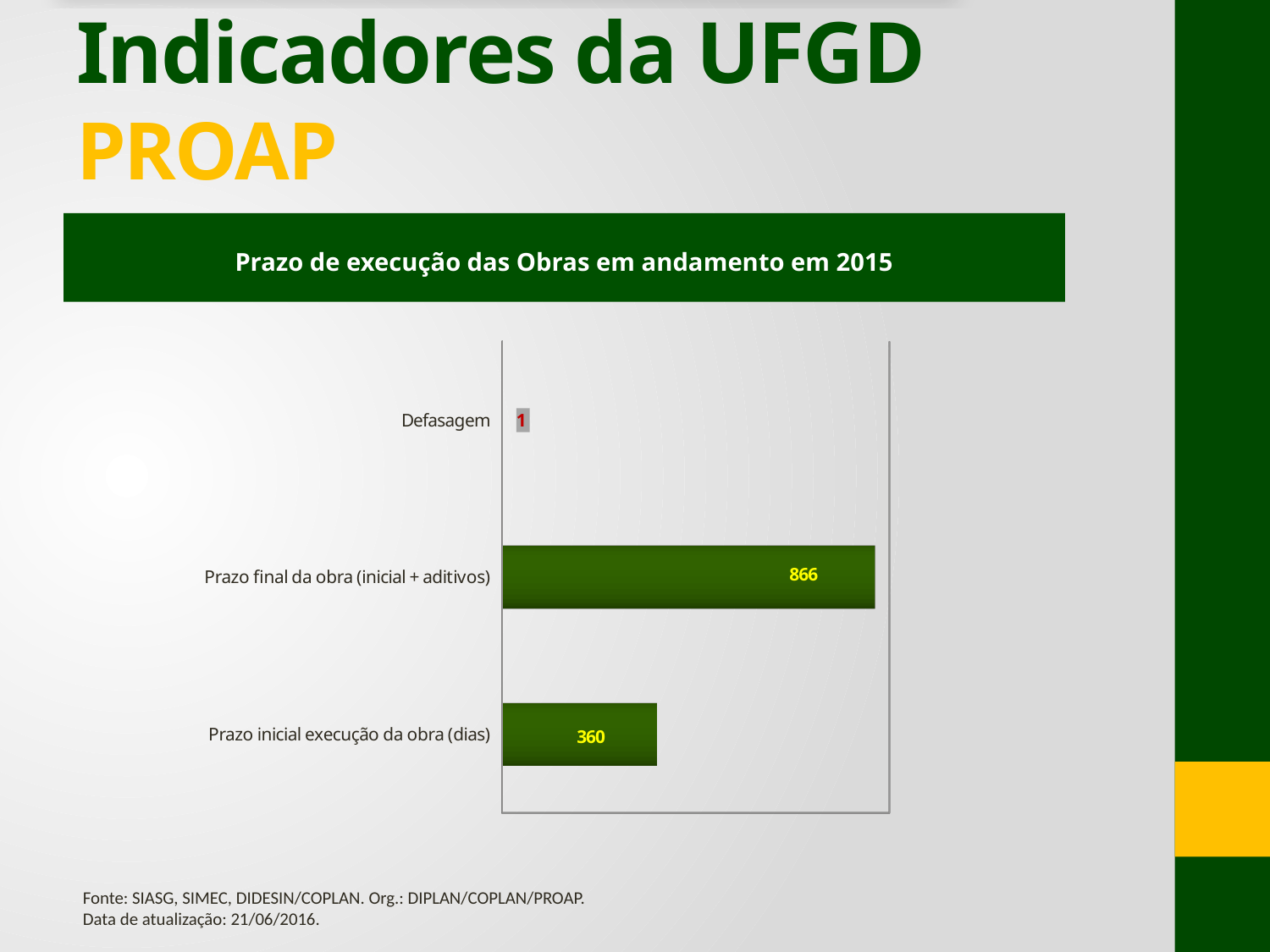
Which category has the highest value? Prazo final da obra (inicial + aditivos) Which category has the lowest value? Defasagem What is the value for 'Prazo inicial execução da obra (dias)'? 360 What is the title of the chart? Prazo de execução das Obras em andamento em 2015 Which is larger: 'Prazo inicial execução da obra (dias)' or 'Prazo final da obra (inicial + aditivos)'? Prazo final da obra (inicial + aditivos) How many categories are shown in the chart? 3 What is the difference between 'Prazo final da obra (inicial + aditivos)' and 'Prazo inicial execução da obra (dias)'? 506 What kind of chart is shown on the slide? Bar chart What is the data update date given below the chart? 21/06/2016 What is the value for 'Prazo final da obra (inicial + aditivos)'? 866